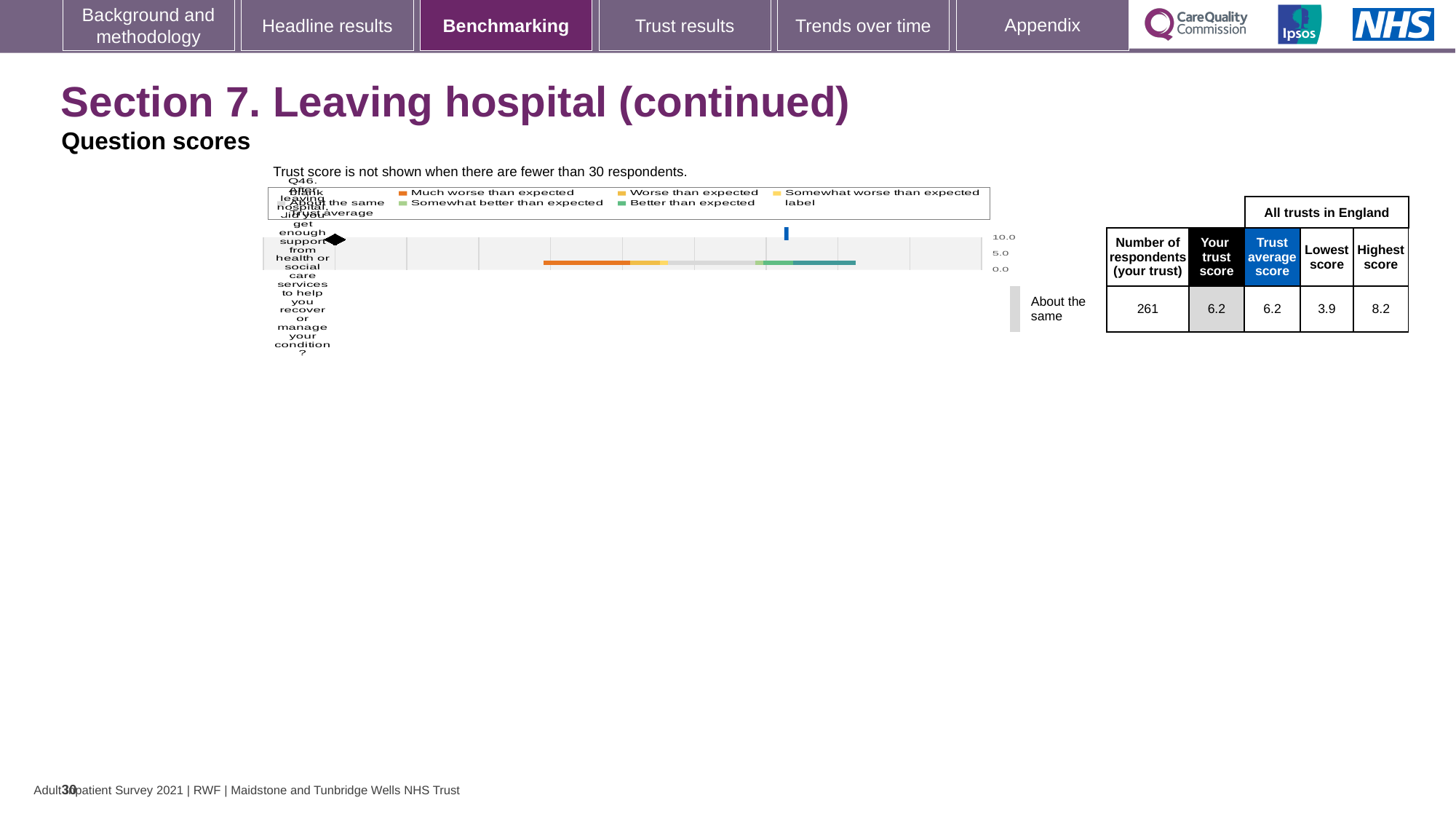
In the table beside the chart, how many respondents from the trust answered Q46? 261 Is the trust's score for Q46 greater or less than 5.0? greater In the table beside the chart, what is the lowest score among all trusts in England for Q46? 3.9 What is the highest value shown on the chart's axis? 10.0 How many questions (categories) are plotted on the chart? 1 In the table beside the chart, what is the trust average score for Q46? 6.2 According to the label next to the chart, how does the trust's score for Q46 compare with what is expected? About the same What is the difference between the highest score and the lowest score for Q46 shown in the table? 4.3 What kind of chart is shown on the slide? bar chart In the table beside the chart, what is the highest score among all trusts in England for Q46? 8.2 Which question number is plotted on the chart? Q46 In the table beside the chart, what is the trust's score for Q46? 6.2